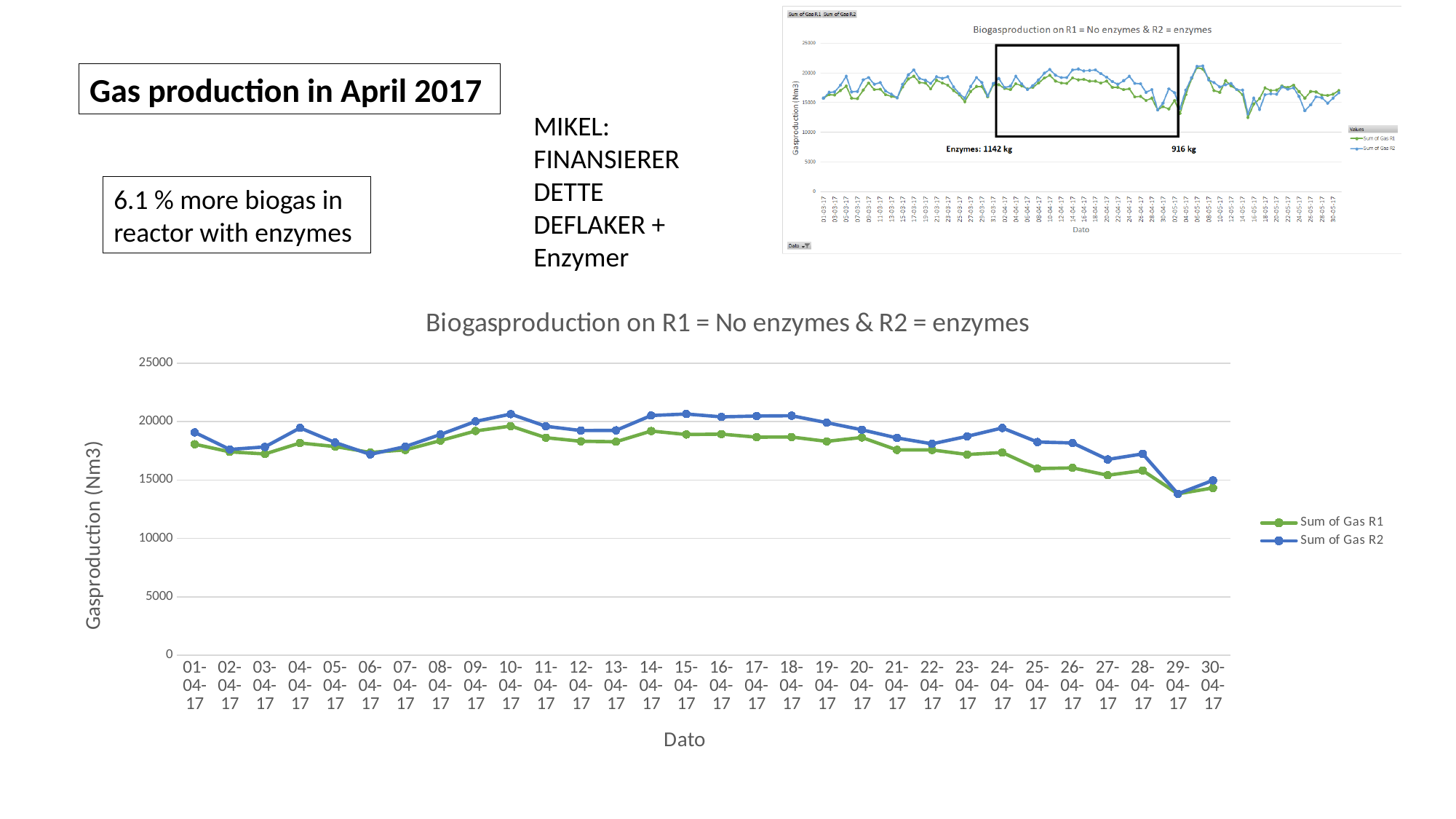
In the large chart at the bottom of the slide, what is the label on the y axis? Gasproduction (Nm3) In the large chart at the bottom of the slide, is the value for Sum of Gas R2 on 10-04-17 greater or less than 20000? greater In the large chart at the bottom of the slide, is the value for Sum of Gas R1 on 29-04-17 greater or less than 15000? less In the large chart at the bottom of the slide, which series has the higher value on 25-04-17, Sum of Gas R1 or Sum of Gas R2? Sum of Gas R2 In the large chart at the bottom of the slide, what type of chart is used? Line chart In the large chart at the bottom of the slide, on which date is Sum of Gas R2 at its lowest? 29-04-17 In the large chart at the bottom of the slide, how many dates are plotted along the x axis? 30 In the large chart at the bottom of the slide, on which date is Sum of Gas R1 at its lowest? 29-04-17 In the large chart at the bottom of the slide, is the value for Sum of Gas R1 on 01-04-17 greater or less than 15000? greater In the large chart at the bottom of the slide, what is the title of the chart? Biogasproduction on R1 = No enzymes & R2 = enzymes In the large chart at the bottom of the slide, does Sum of Gas R1 rise or fall from 24-04-17 to 29-04-17? fall In the large chart at the bottom of the slide, how many series does the legend list? 2